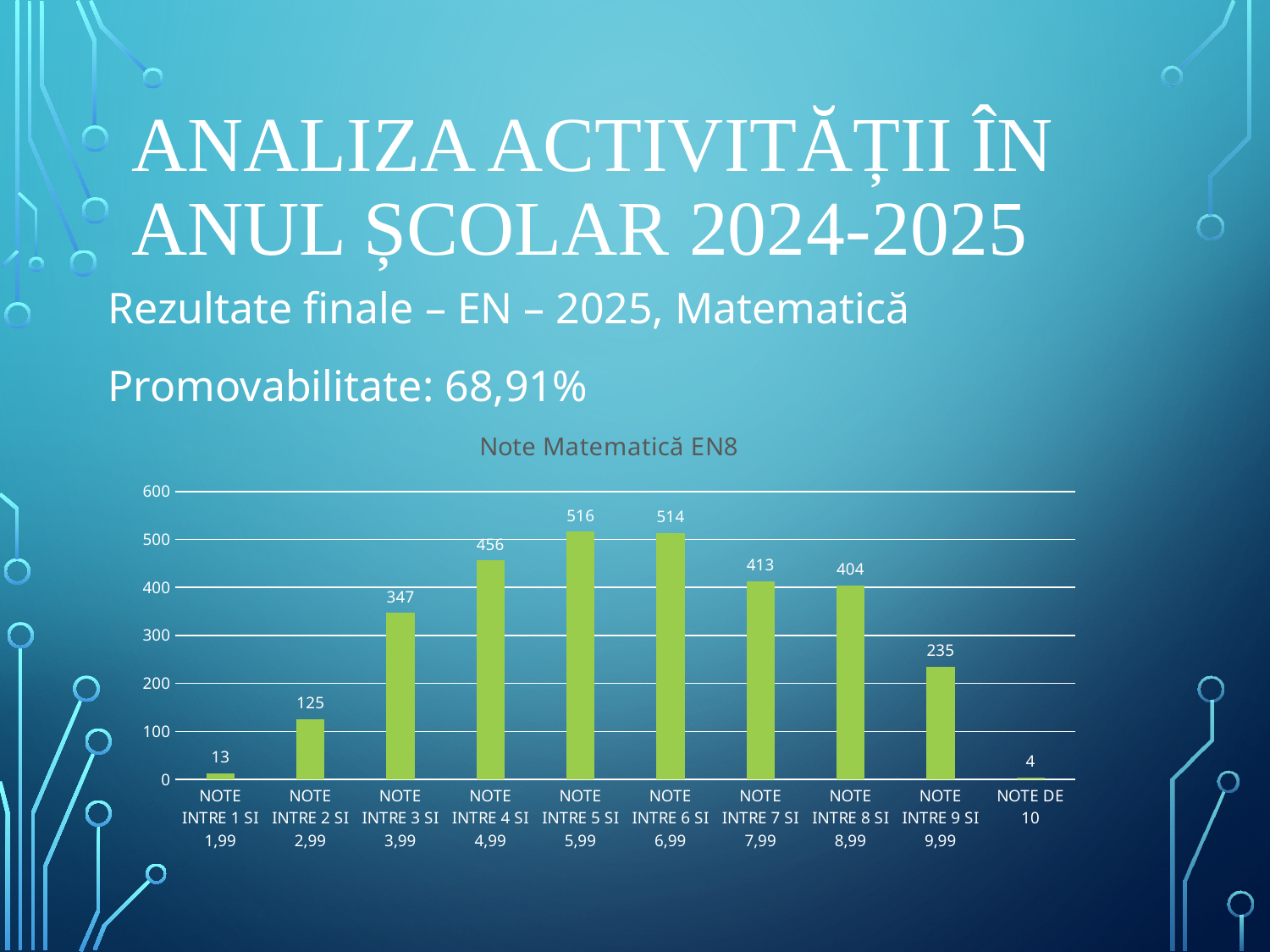
Which category has the lowest value? NOTE DE 10 What is the difference between the values for NOTE INTRE 1 SI 1,99 and NOTE DE 10? 9 What is the value for NOTE INTRE 9 SI 9,99? 235 What kind of chart is shown on the slide? bar chart What is the value for NOTE DE 10? 4 Which is larger, the value for NOTE INTRE 7 SI 7,99 or NOTE INTRE 8 SI 8,99? NOTE INTRE 7 SI 7,99 What is the value for NOTE INTRE 5 SI 5,99? 516 What is the difference between the values for NOTE INTRE 4 SI 4,99 and NOTE INTRE 3 SI 3,99? 109 How many categories are shown on the x axis? 10 What is the title of the chart? Note Matematică EN8 Is the value for NOTE INTRE 2 SI 2,99 greater or less than 200? less Which category has the highest value? NOTE INTRE 5 SI 5,99